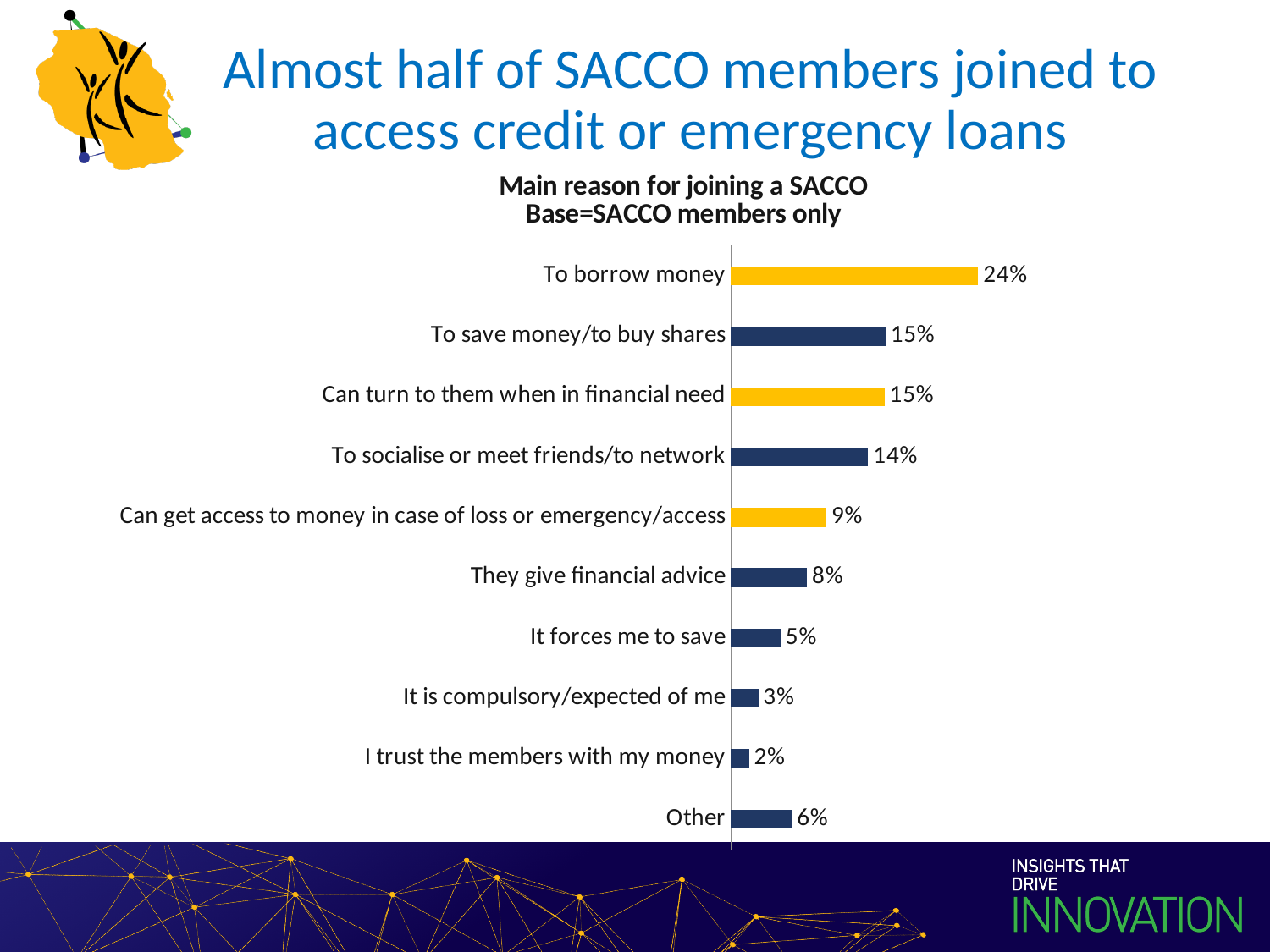
How many reasons (categories) are shown in the chart? 10 What is the value for 'Other'? 6% Which reason for joining a SACCO has the lowest percentage? I trust the members with my money What is the difference between 'Can get access to money in case of loss or emergency/access' and 'It forces me to save'? 4 Which reason for joining a SACCO has the highest percentage? To borrow money What type of chart is used on this slide? Bar chart What is the title of the chart? Main reason for joining a SACCO Base=SACCO members only What is the value for 'To socialise or meet friends/to network'? 14% Which is larger: 'It is compulsory/expected of me' or 'Other'? Other What percentage is shown for 'They give financial advice'? 8% What percentage of SACCO members gave 'To borrow money' as their main reason for joining? 24% What is the difference in percentage points between 'To borrow money' and 'To save money/to buy shares'? 9